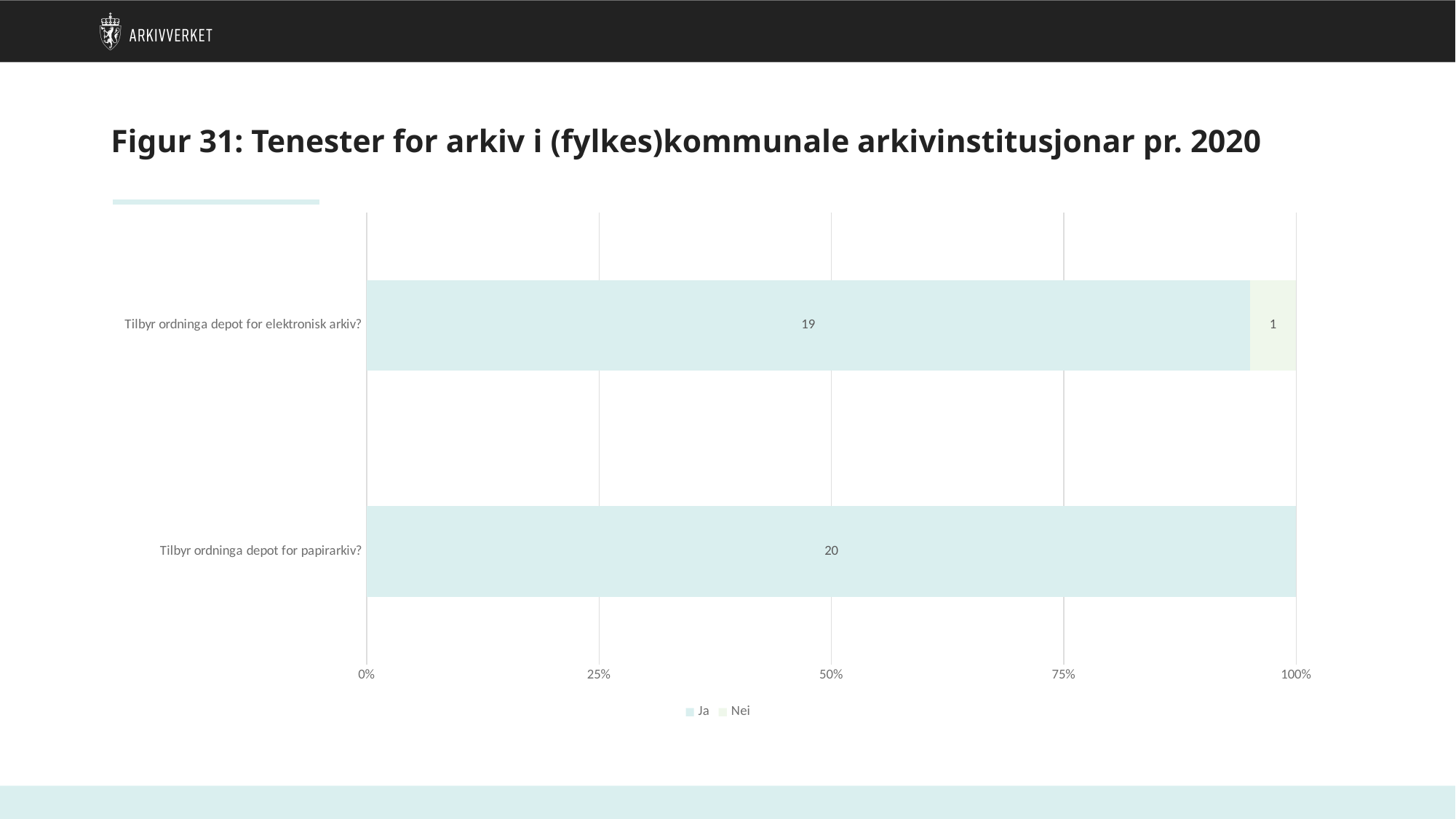
How many categories are shown on the chart? 2 What is the total of the stacked bar for 'Tilbyr ordninga depot for elektronisk arkiv?'? 20 What are the two series named in the legend? Ja and Nei What is the difference between the 'Ja' values for 'Tilbyr ordninga depot for papirarkiv?' and 'Tilbyr ordninga depot for elektronisk arkiv?'? 1 Is the 'Ja' share for 'Tilbyr ordninga depot for elektronisk arkiv?' greater or less than 75%? greater Is the 'Nei' share for 'Tilbyr ordninga depot for elektronisk arkiv?' greater or less than 25%? less Which category has the higher 'Ja' value? Tilbyr ordninga depot for papirarkiv? What kind of chart is shown on the slide? Stacked bar chart What is the 'Nei' value for 'Tilbyr ordninga depot for elektronisk arkiv?'? 1 What is the 'Ja' value for 'Tilbyr ordninga depot for papirarkiv?'? 20 What is the 'Ja' value for 'Tilbyr ordninga depot for elektronisk arkiv?'? 19 How many series does the legend list? 2